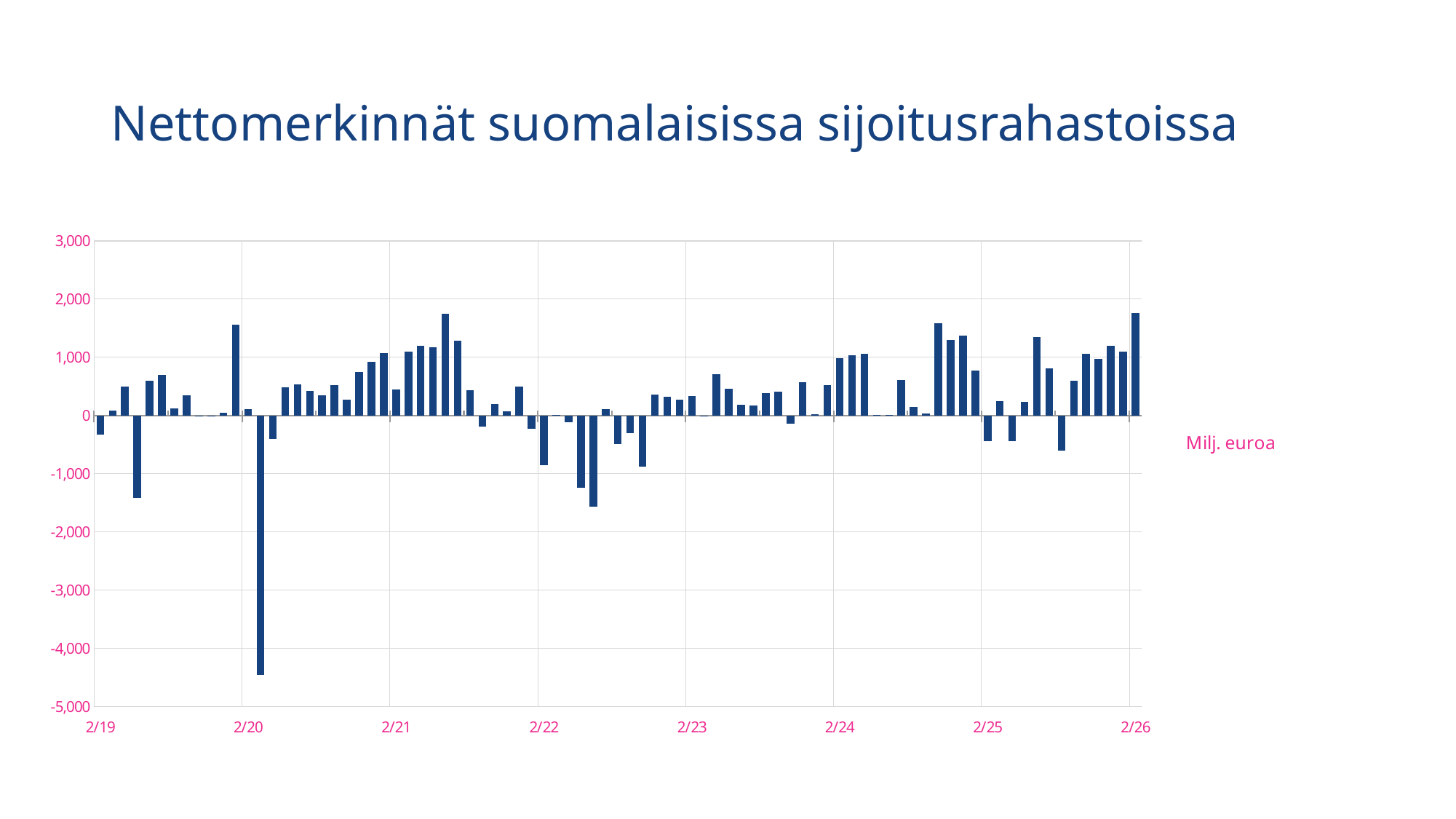
What unit is shown next to the chart? Milj. euroa Which is larger, the value for 2/26 or the value for 2/19? 2/26 How many labels are shown on the x axis? 8 Is the value for 2/21 greater or less than 0? greater Does the lowest bar on the chart occur shortly after 2/20 or shortly after 2/22? shortly after 2/20 What kind of chart is shown on the slide? bar chart Is the lowest value on the chart greater or less than -4,000? less Is the value for 2/19 greater or less than 0? less Which is larger, the value for 2/21 or the value for 2/22? 2/21 What is the title of the chart? Nettomerkinnät suomalaisissa sijoitusrahastoissa